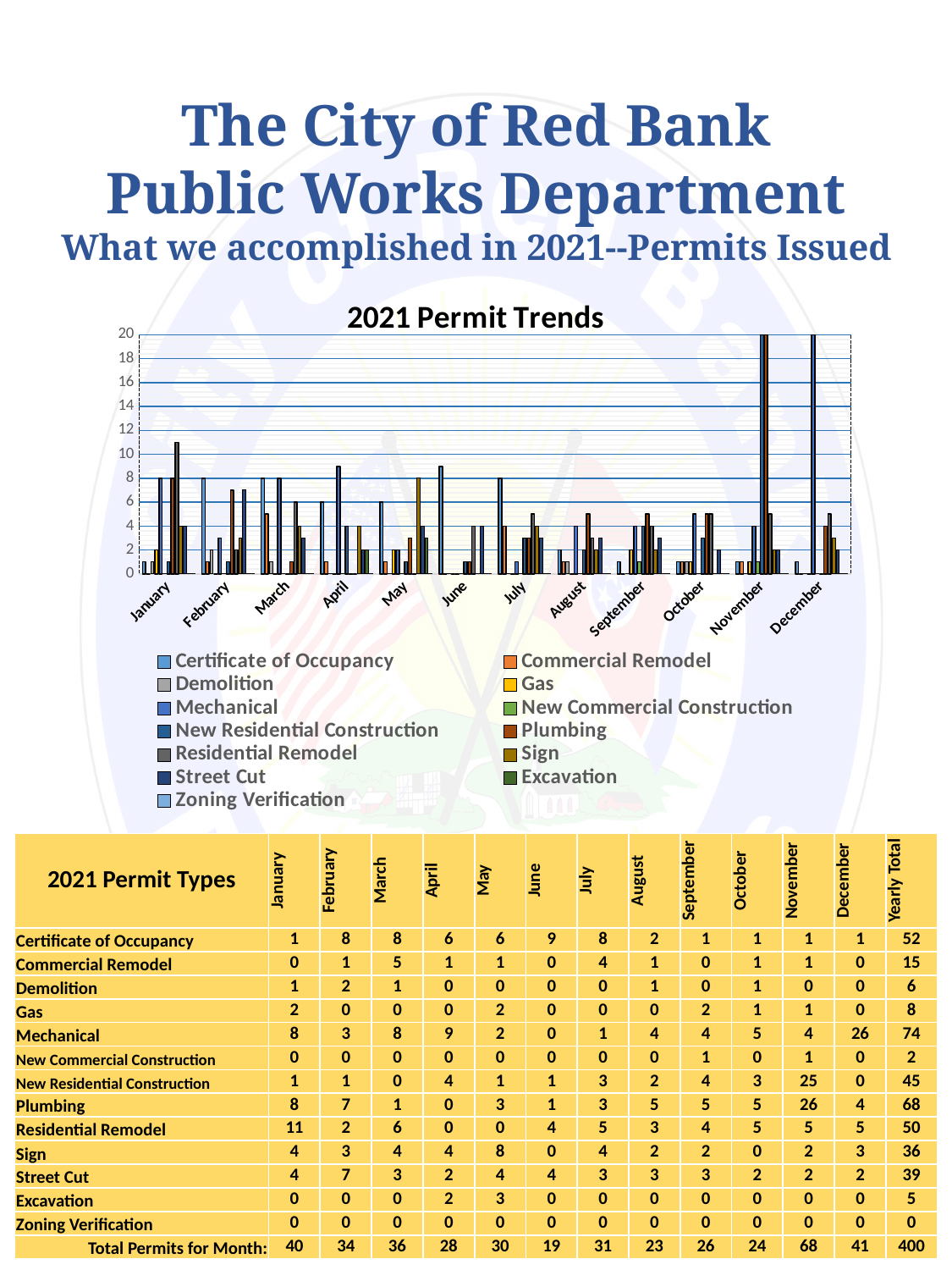
Do Certificate of Occupancy permits rise or fall from June to December? fall What kind of chart is the "2021 Permit Trends" chart? bar chart Which month had the highest total number of permits issued? November What is the title of the chart on the slide? 2021 Permit Trends What is the difference between Certificate of Occupancy permits in February and in January? 7 How many months are shown along the x axis of the "2021 Permit Trends" chart? 12 How many Plumbing permits were issued in November? 26 Is the value for Mechanical in December greater or less than 20? greater How many Mechanical permits were issued in December? 26 How many series does the legend of the "2021 Permit Trends" chart list? 13 Which permit type had the lowest yearly total? Zoning Verification In January, which is larger: Residential Remodel or Mechanical permits? Residential Remodel